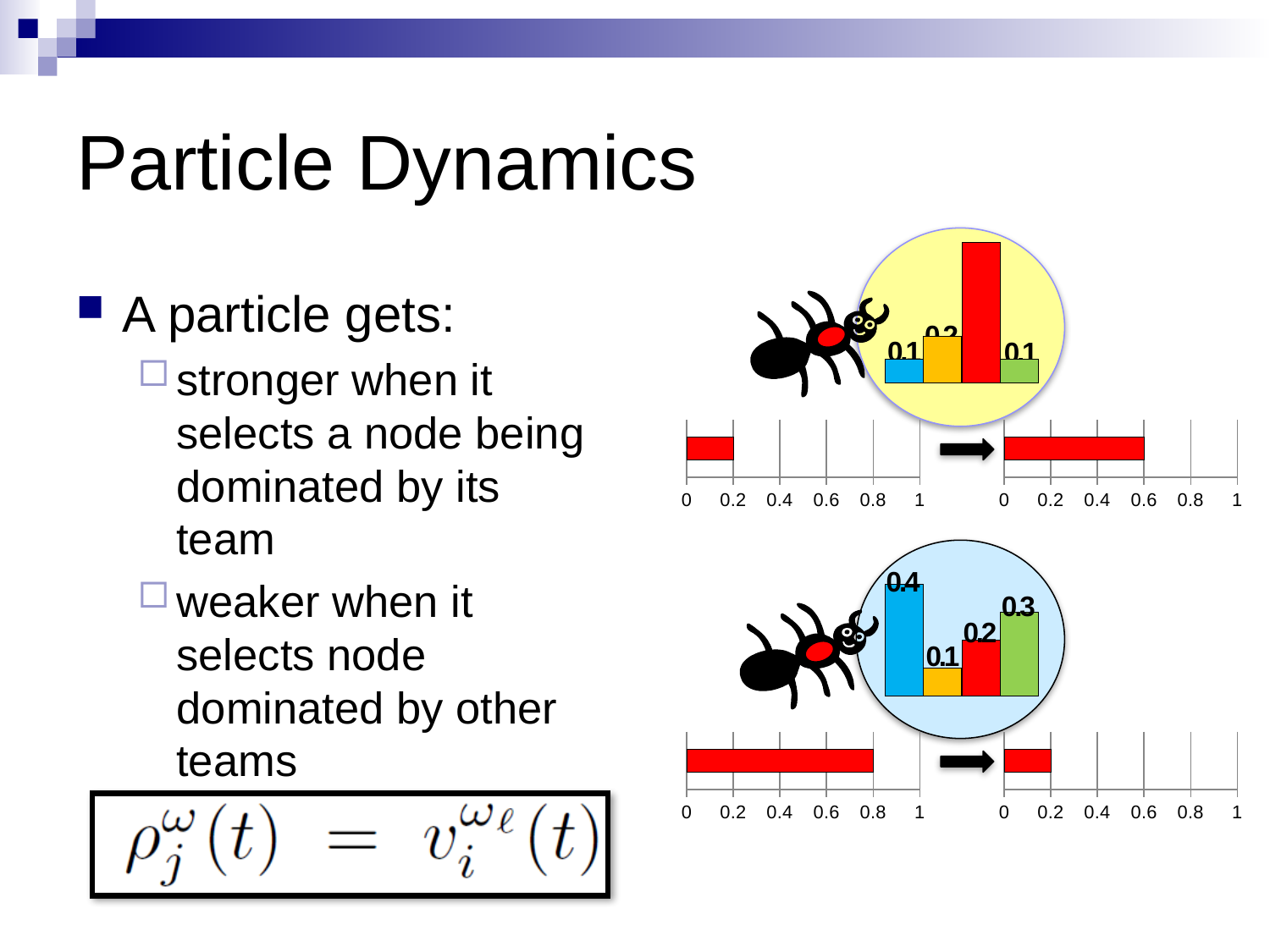
In the horizontal bar chart at the top left (before the arrow), at what value does the red bar end? 0.2 In the bar chart inside the top (yellow) circle, what is the value of the blue bar? 0.1 In the horizontal bar chart at the bottom left (before the arrow), at what value does the red bar end? 0.8 In the bar chart inside the bottom (blue) circle, what is the value of the green bar? 0.3 In the bar chart inside the top (yellow) circle, how many bars are there? 4 What kind of chart is shown inside the bottom (blue) circle? bar chart In the bar chart inside the bottom (blue) circle, which coloured bar is the shortest? orange In the bar chart inside the bottom (blue) circle, which is larger, the red bar or the green bar? green In the horizontal bar chart at the top right (after the arrow), at what value does the red bar end? 0.6 In the bar chart inside the bottom (blue) circle, what is the value of the blue bar? 0.4 In the bar chart inside the top (yellow) circle, which coloured bar is the tallest? red In the bar chart inside the bottom (blue) circle, what is the difference between the blue bar and the red bar? 0.2